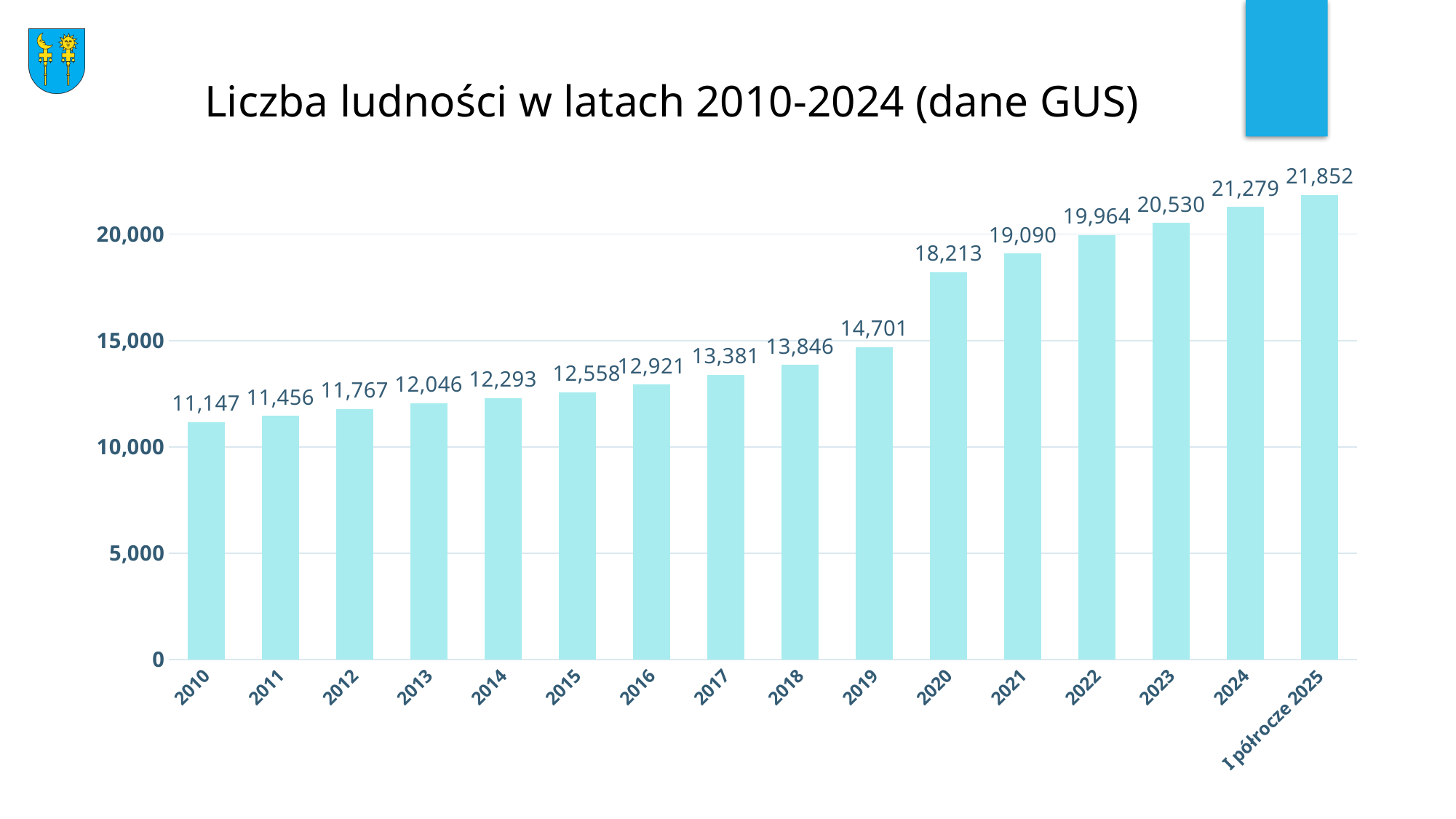
What kind of chart is shown on the slide? bar chart Is the value for 2022 greater or less than 15,000? greater Do the values rise or fall from 2010 to 2024? rise What is the difference between the values for 2020 and 2019? 3,512 What is the difference between the values for 2024 and 2010? 10,132 What is the value shown for I półrocze 2025? 21,852 How many bars are shown in the chart? 16 What is the population value shown for 2020? 18,213 Which year has the lowest value? 2010 Which is larger, the value for 2015 or the value for 2018? 2018 Which category has the highest value? I półrocze 2025 What is the population value shown for 2010? 11,147